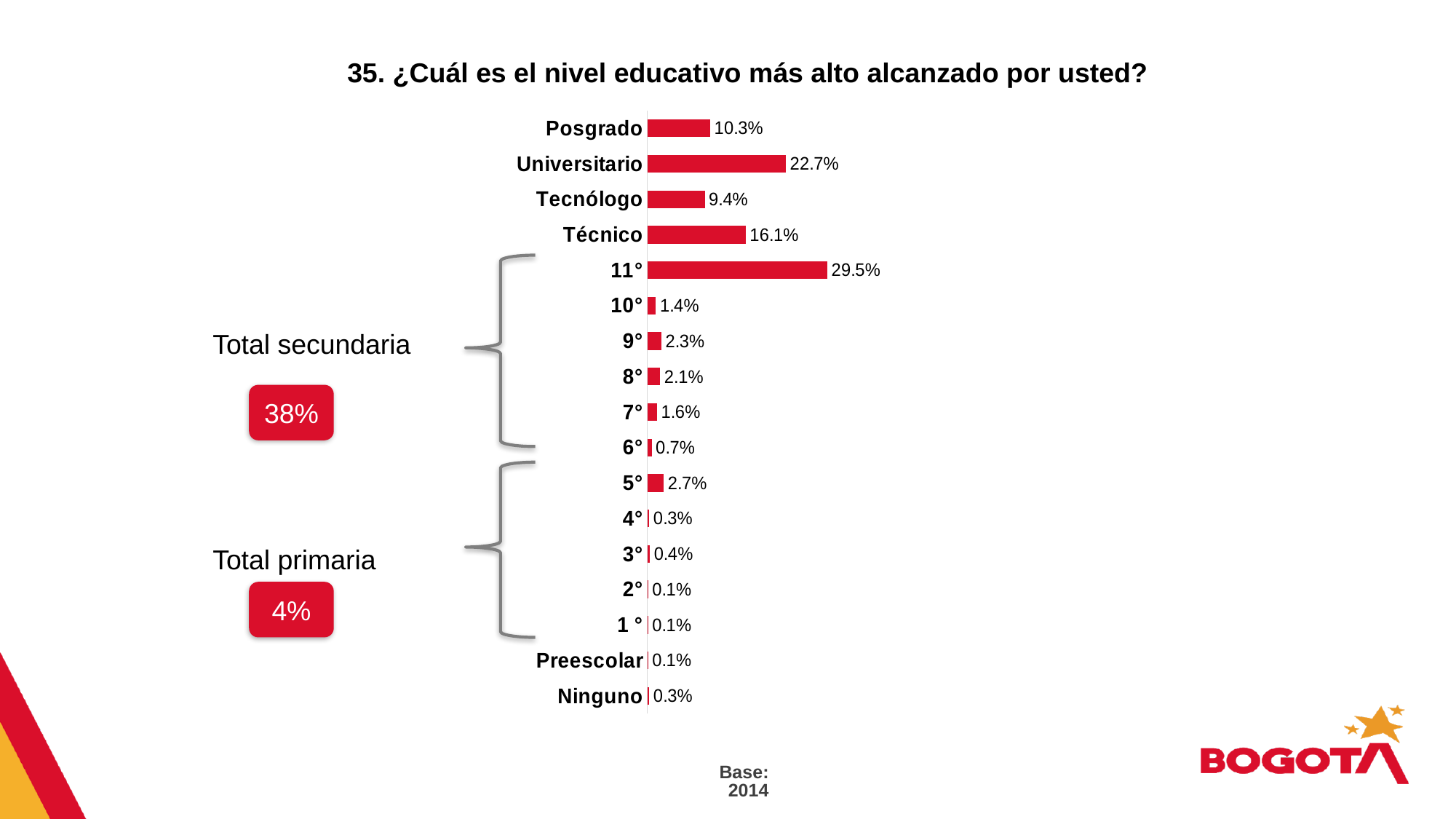
What percentage of respondents reported Universitario as their highest education level? 22.7% Which is larger, the value for Técnico or the value for Tecnólogo? Técnico What total percentage is shown for 'Total secundaria' on the slide? 38% What is the value shown for Tecnólogo? 9.4% Which category has the highest value in the chart? 11° What is the value shown for 11°? 29.5% What is the difference between the values for Universitario and Posgrado? 12.4% How many categories are plotted in the chart? 17 What is the value shown for Posgrado? 10.3% What kind of chart is shown on the slide? Bar chart Which is larger, the value for 5° or the value for 6°? 5° What is the difference between the values for 11° and Universitario? 6.8%